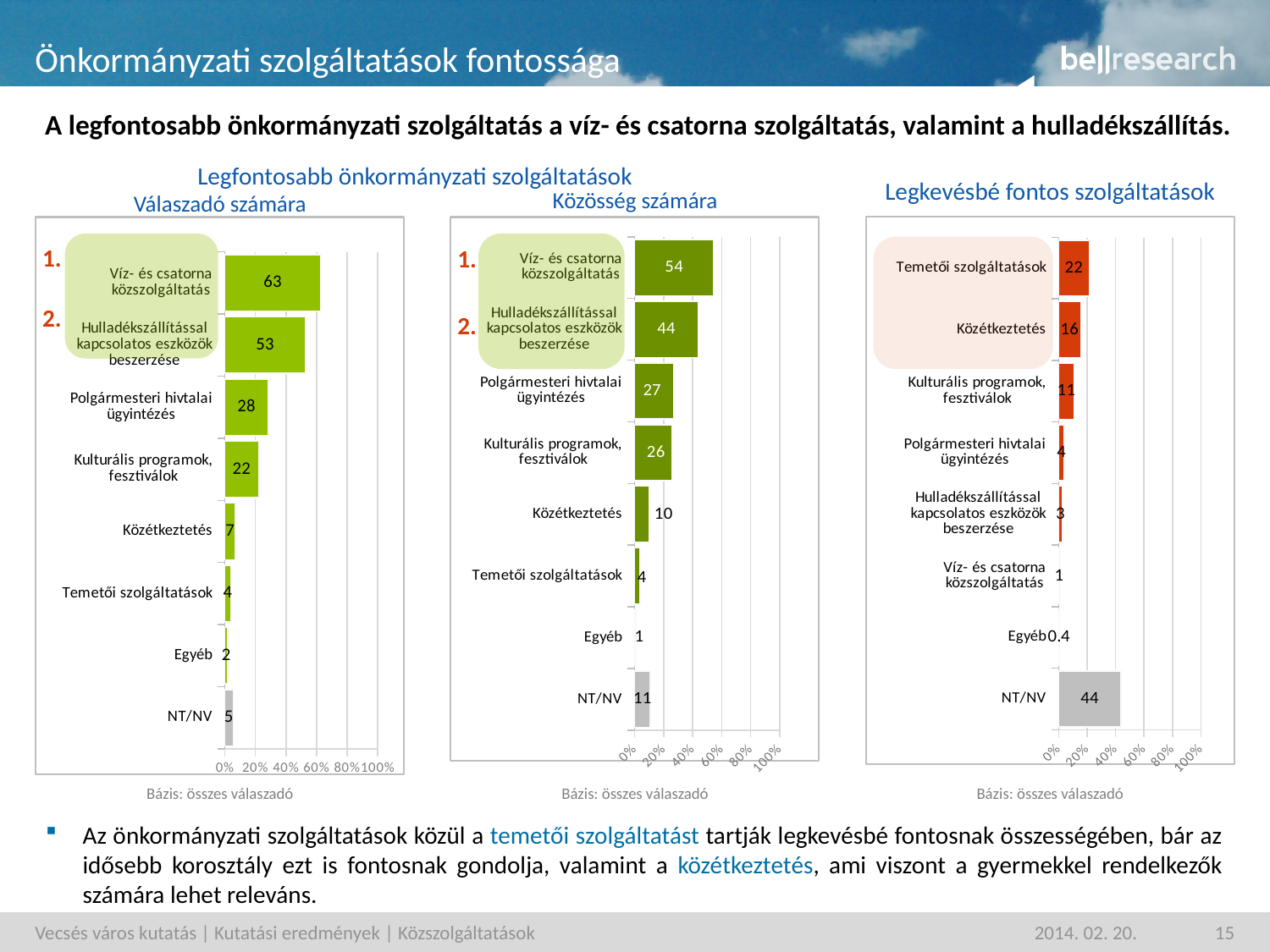
In the 'Közösség számára' chart, what is the value for Hulladékszállítással kapcsolatos eszközök beszerzése? 44 In the 'Közösség számára' chart, which category has the highest value? Víz- és csatorna közszolgáltatás What kind of chart is the 'Közösség számára' chart? Bar chart In the 'Válaszadó számára' chart, what is the difference between the values for Víz- és csatorna közszolgáltatás and Hulladékszállítással kapcsolatos eszközök beszerzése? 10 In the 'Legkevésbé fontos szolgáltatások' chart, what is the difference between the values for Temetői szolgáltatások and Közétkeztetés? 6 How many categories are shown in the 'Válaszadó számára' chart? 8 In the 'Közösség számára' chart, which is larger: the value for Polgármesteri hivatalai ügyintézés or the value for Kulturális programok, fesztiválok? Polgármesteri hivatalai ügyintézés In the 'Válaszadó számára' chart, what is the value for Polgármesteri hivatalai ügyintézés? 28 In the 'Legkevésbé fontos szolgáltatások' chart, which category has the lowest value? Egyéb In the 'Legkevésbé fontos szolgáltatások' chart, what is the value for NT/NV? 44 In the 'Legkevésbé fontos szolgáltatások' chart, what is the value for Közétkeztetés? 16 In the 'Válaszadó számára' chart, what is the value for Víz- és csatorna közszolgáltatás? 63